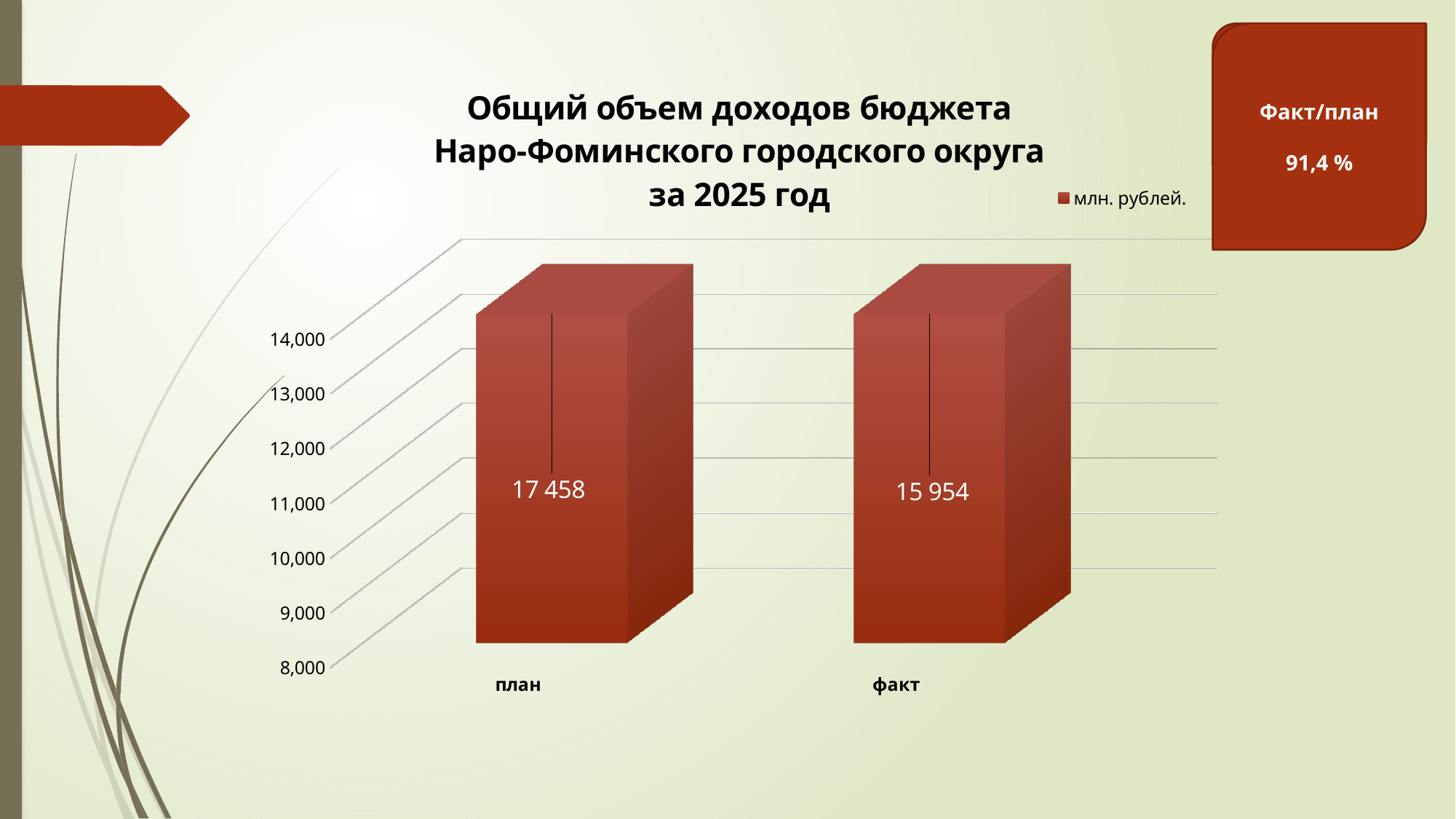
What is the value for план? 17 458 Which category has the lowest value? факт What kind of chart is shown on the slide? bar chart What is the legend entry of the chart? млн. рублей. Which category has the highest value? план What is the value for факт? 15 954 How many series does the legend list? 1 Which category has the higher value, план or факт? план What is the title of the chart? Общий объем доходов бюджета Наро-Фоминского городского округа за 2025 год Do the values rise or fall from план to факт? fall What is the difference between the план and факт values? 1 504 How many categories are shown on the x axis? 2